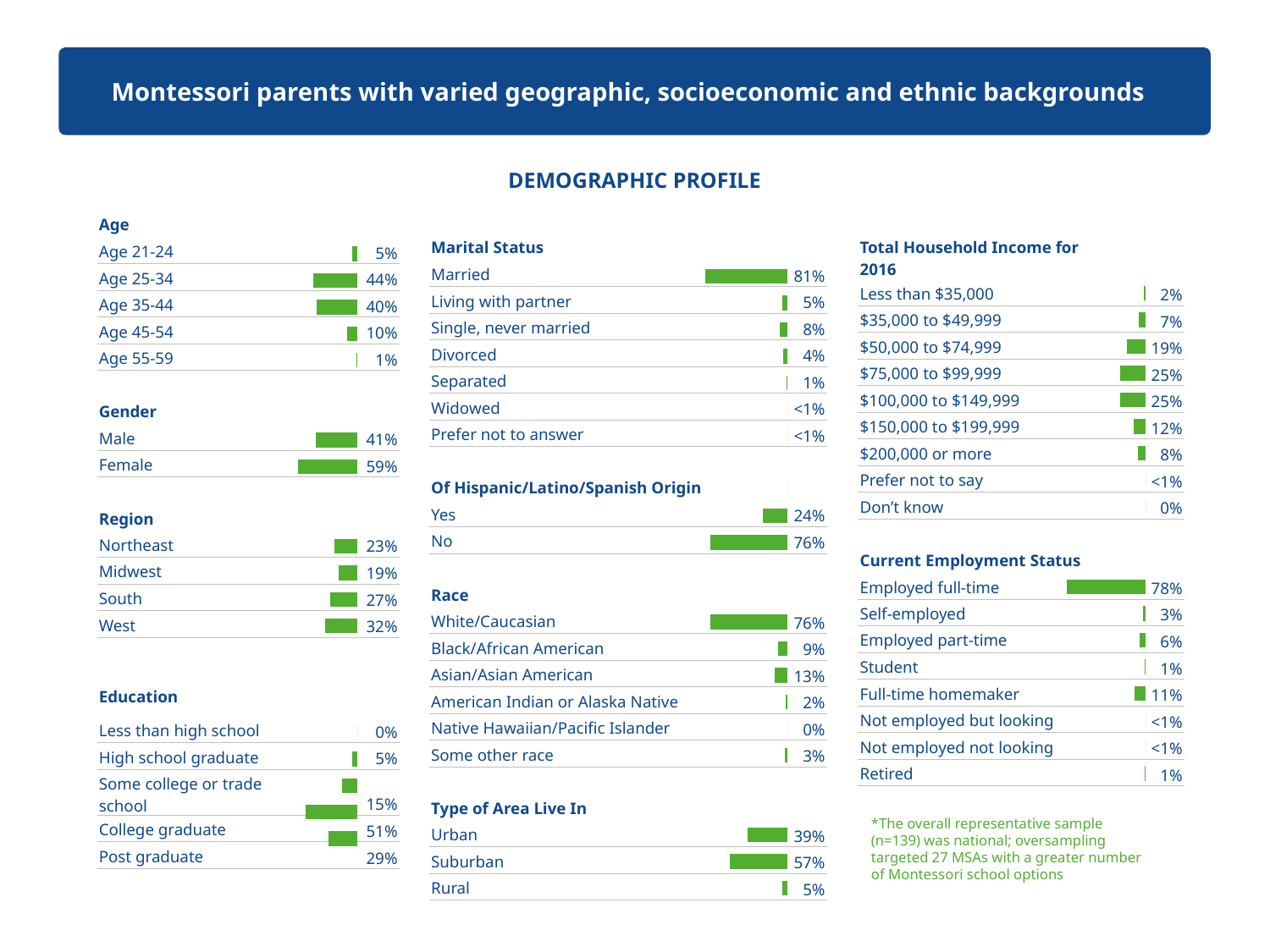
In the Race chart, which category has the lowest percentage? Native Hawaiian/Pacific Islander In the Type of Area Live In chart, what is the value for Suburban? 57% What kind of chart is used to show the Of Hispanic/Latino/Spanish Origin data? Bar chart In the Age chart, what percentage of Montessori parents are aged 25-34? 44% In the Marital Status chart, how many categories are listed? 7 In the Race chart, which is larger, Black/African American or Asian/Asian American? Asian/Asian American In the Marital Status chart, what percentage are Married? 81% In the Current Employment Status chart, what is the difference between Employed full-time and Full-time homemaker? 67% In the Region chart, which region has the highest percentage? West In the Region chart, what is the difference between the South and Midwest percentages? 8% In the Gender chart, what is the value for Female? 59% In the Total Household Income for 2016 chart, what percentage earn $150,000 to $199,999? 12%